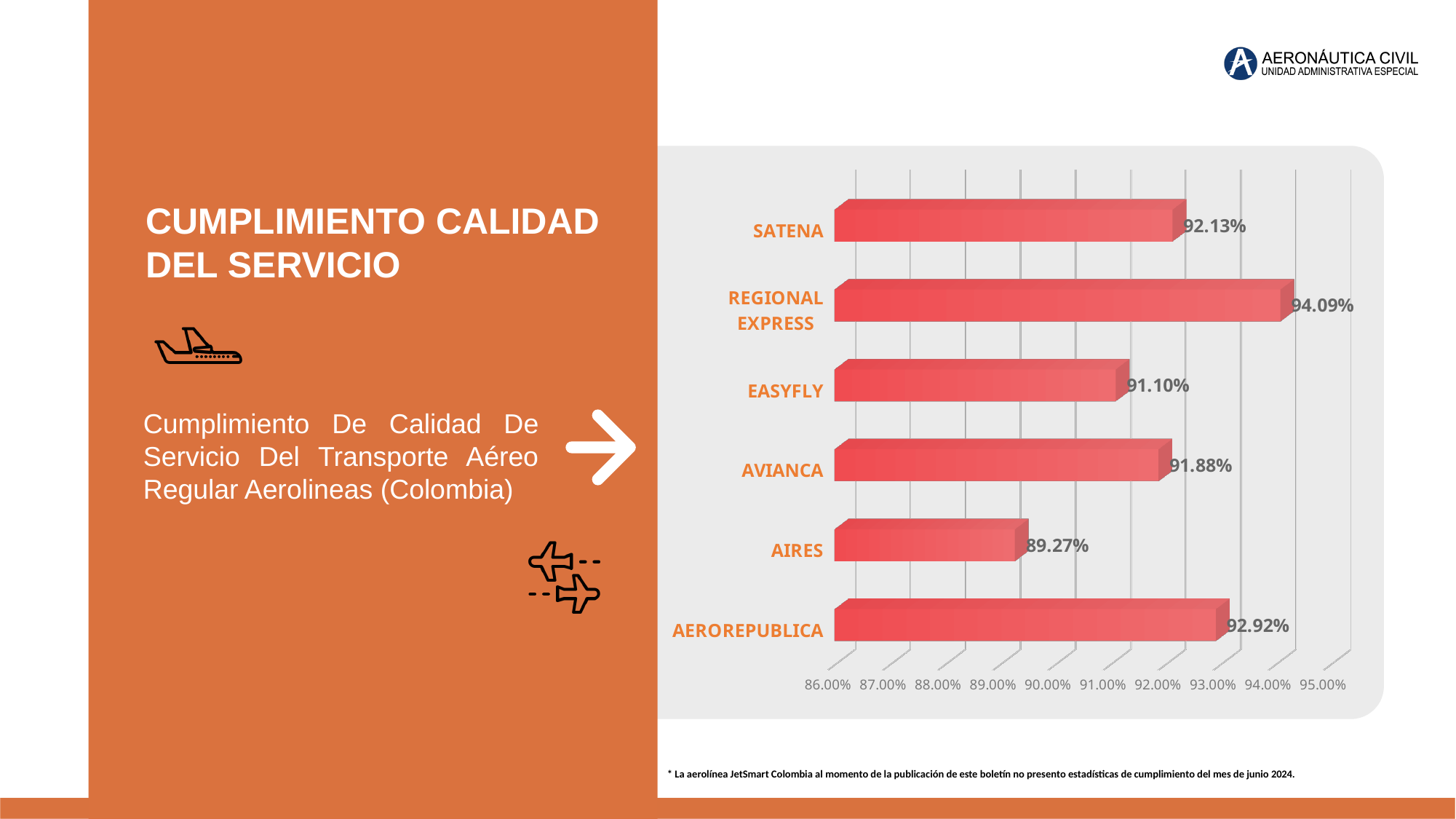
What is the difference between the values for AEROREPUBLICA and SATENA? 0.79 percentage points Is the value for AIRES greater or less than 90.00%? less What kind of chart is shown on the slide? Bar chart What is the difference between the values for REGIONAL EXPRESS and AIRES? 4.82 percentage points Which airline has the highest value? REGIONAL EXPRESS What is the value for REGIONAL EXPRESS? 94.09% What is the value for AIRES? 89.27% What is the value for AEROREPUBLICA? 92.92% What is the value for SATENA? 92.13% How many airlines are shown in the chart? 6 Which is larger, the value for AVIANCA or the value for EASYFLY? AVIANCA Which airline has the lowest value? AIRES